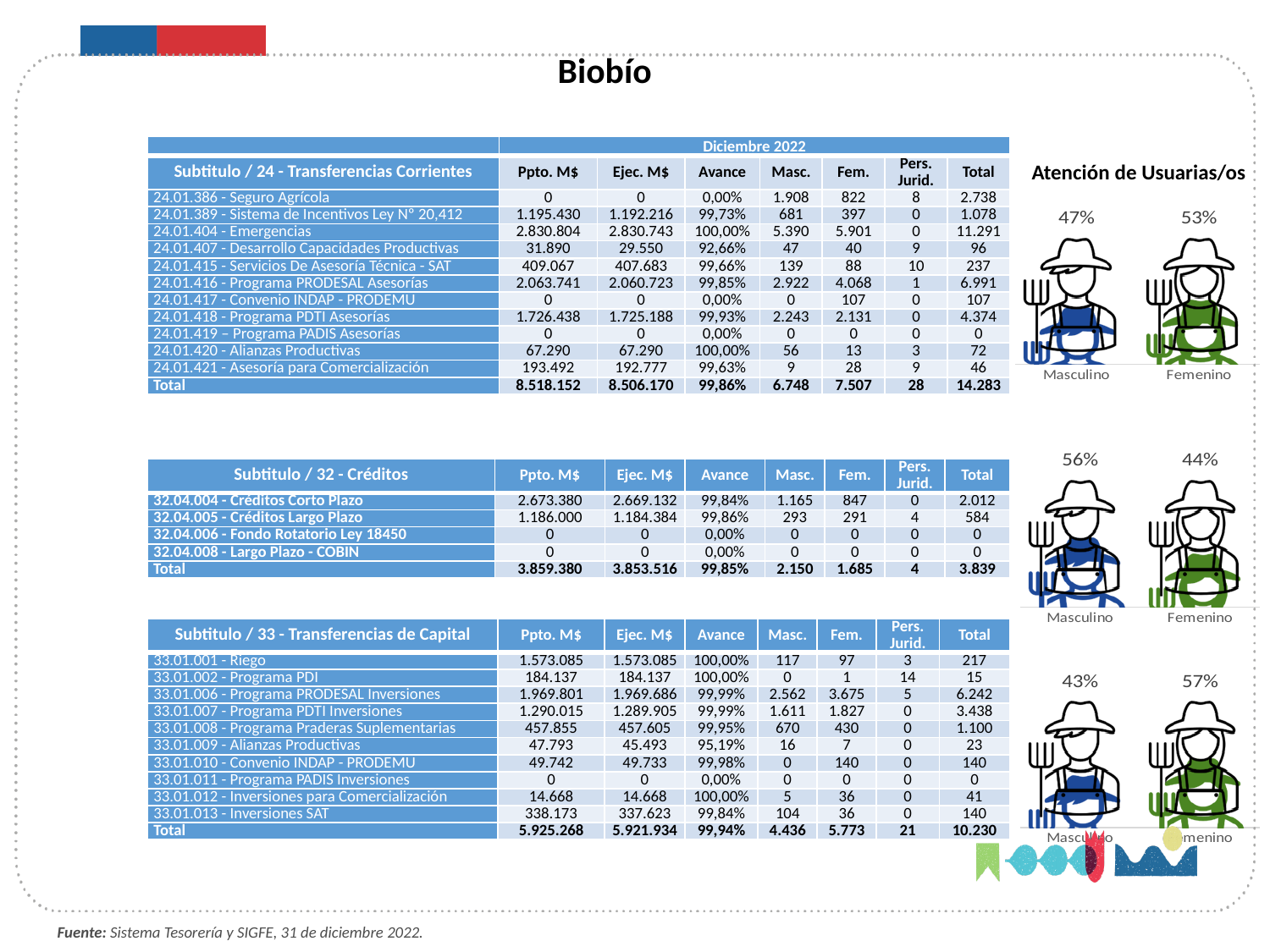
In the top 'Atención de Usuarias/os' chart, which category has the larger share, Masculino or Femenino? Femenino In the middle user-attention chart on the right side of the slide, what percentage is shown for Masculino? 56% How many categories does each user-attention chart on the right side of the slide show? 2 In the middle user-attention chart on the right side of the slide, what percentage is shown for Femenino? 44% In the top 'Atención de Usuarias/os' chart, what is the difference between the Femenino and Masculino percentages? 6% In the middle user-attention chart on the right side of the slide, what is the difference between the Masculino and Femenino percentages? 12% In the top 'Atención de Usuarias/os' chart, what percentage is shown for Femenino? 53% In the bottom user-attention chart on the right side of the slide, which category is lowest? Masculino In the middle user-attention chart on the right side of the slide, which category is highest? Masculino In the bottom user-attention chart on the right side of the slide, what percentage is shown for Femenino? 57% In the top 'Atención de Usuarias/os' chart, what percentage is shown for Masculino? 47% What is the title shown above the top user-attention chart on the right side of the slide? Atención de Usuarias/os